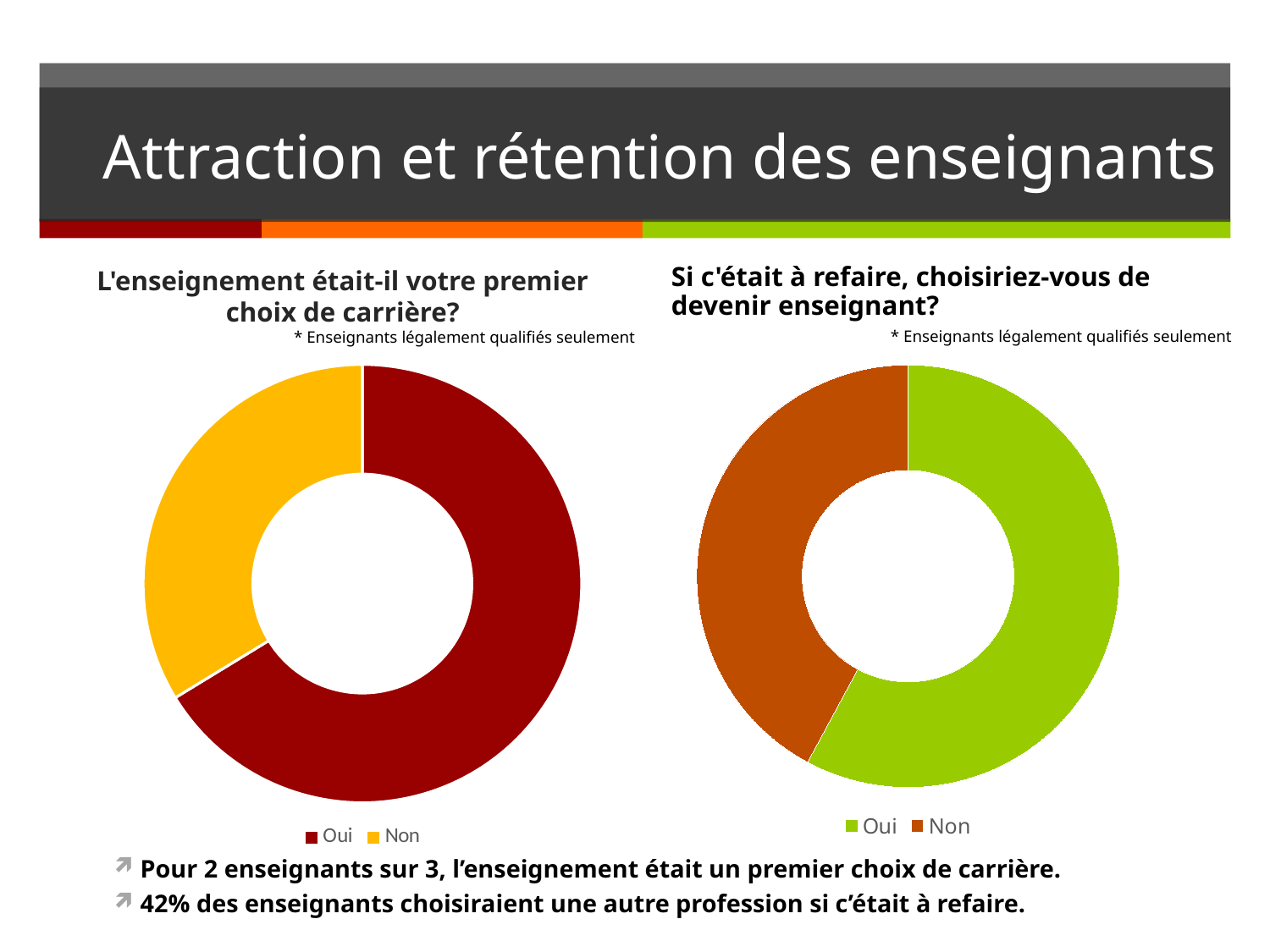
In the chart titled "Si c'était à refaire, choisiriez-vous de devenir enseignant?", is the share for Non larger or smaller than the share for Oui? Smaller What kind of chart is the chart titled "Si c'était à refaire, choisiriez-vous de devenir enseignant?"? Doughnut chart What kind of chart is the chart titled "L'enseignement était-il votre premier choix de carrière?"? Doughnut chart In the chart titled "L'enseignement était-il votre premier choix de carrière?", which category has the largest share? Oui In the chart titled "Si c'était à refaire, choisiriez-vous de devenir enseignant?", which category has the smallest share? Non How many categories does the legend of the chart titled "L'enseignement était-il votre premier choix de carrière?" list? 2 In the chart titled "L'enseignement était-il votre premier choix de carrière?", is the share for Oui larger or smaller than the share for Non? Larger In the chart titled "L'enseignement était-il votre premier choix de carrière?", what colour represents the Non category? Yellow In the chart titled "Si c'était à refaire, choisiriez-vous de devenir enseignant?", which category has the largest share? Oui How many categories does the legend of the chart titled "Si c'était à refaire, choisiriez-vous de devenir enseignant?" list? 2 In the chart titled "L'enseignement était-il votre premier choix de carrière?", which category has the smallest share? Non In the chart titled "Si c'était à refaire, choisiriez-vous de devenir enseignant?", what colour represents the Oui category? Green